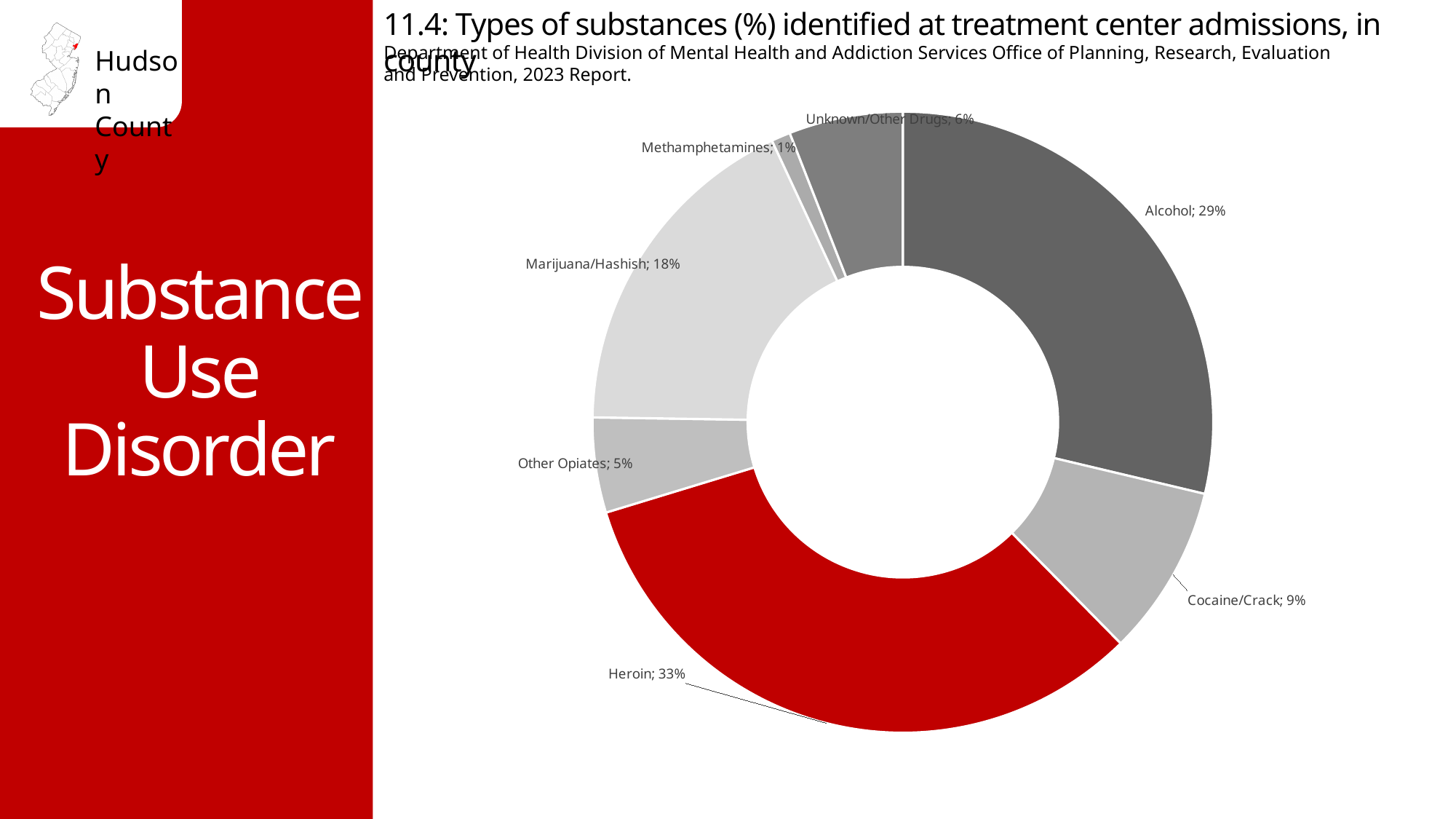
Which has a larger share, Cocaine/Crack or Unknown/Other Drugs? Cocaine/Crack Which slice of the chart is coloured red? Heroin Which substance has the largest share of treatment center admissions? Heroin What percentage of treatment center admissions is attributed to Heroin? 33% How many substance categories are shown in the chart? 7 What is the difference in percentage points between Heroin and Alcohol? 4 What percentage is shown for Cocaine/Crack? 9% What percentage is shown for Marijuana/Hashish? 18% What type of chart is used to show the types of substances? Doughnut (pie) chart What is the difference in percentage points between Marijuana/Hashish and Other Opiates? 13 Which substance has the smallest share of treatment center admissions? Methamphetamines What percentage of treatment center admissions is attributed to Alcohol? 29%